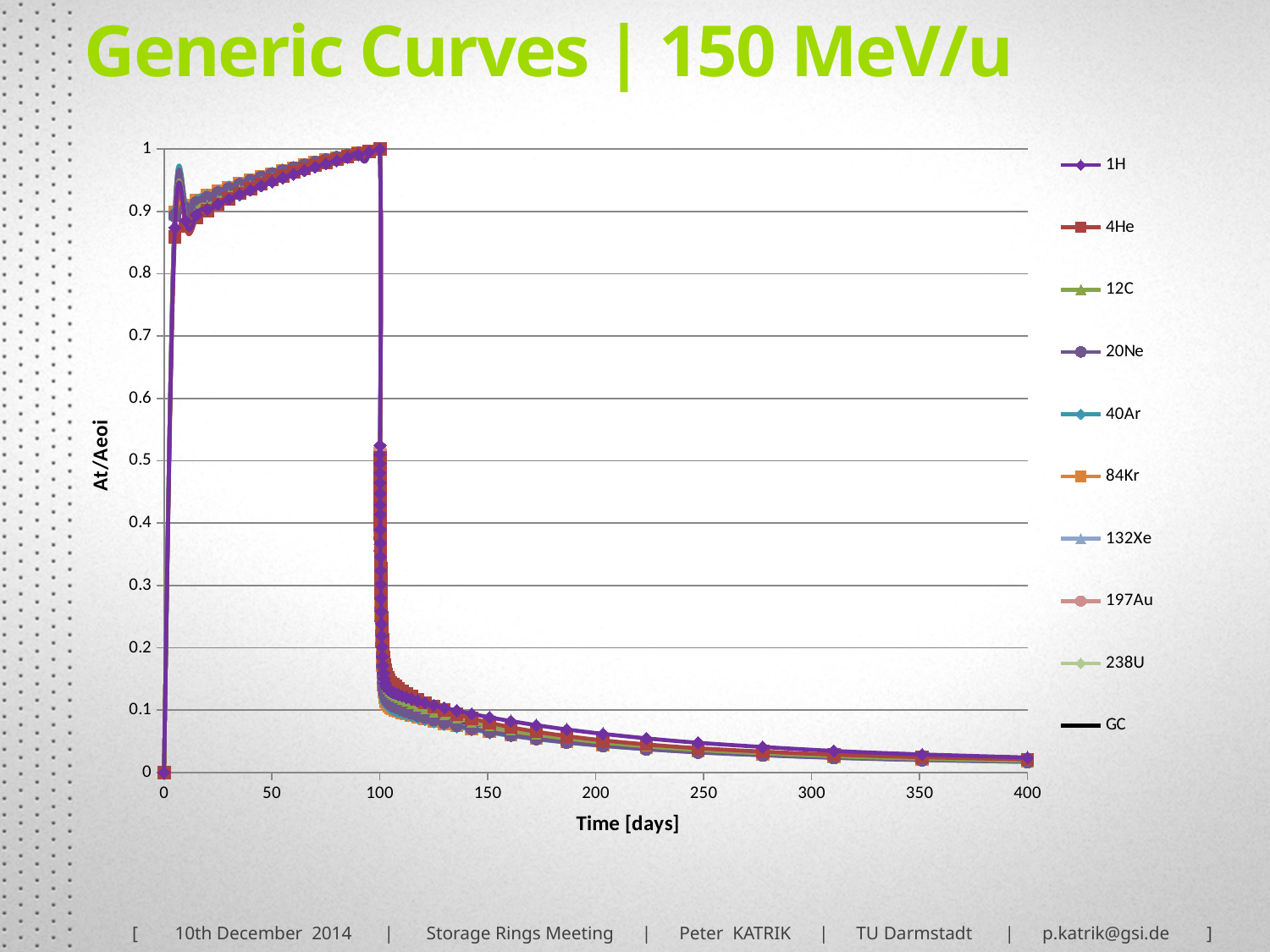
What is the maximum value reached by the curves on the At/Aeoi axis? 1 What is the title of the chart? Generic Curves | 150 MeV/u Is the value of the curves at 200 days greater or less than 0.1? less How many series does the legend list? 10 At what time in days do the curves reach their peak value? 100 What kind of chart is shown on the slide? line chart Is the value of the curves at 300 days greater or less than 0.2? less Do the curves rise or fall between 100 days and 400 days? fall Is the value of the curves at 50 days greater or less than 0.9? greater Do the curves generally rise or fall between 20 days and 100 days? rise What is the label of the x axis? Time [days]